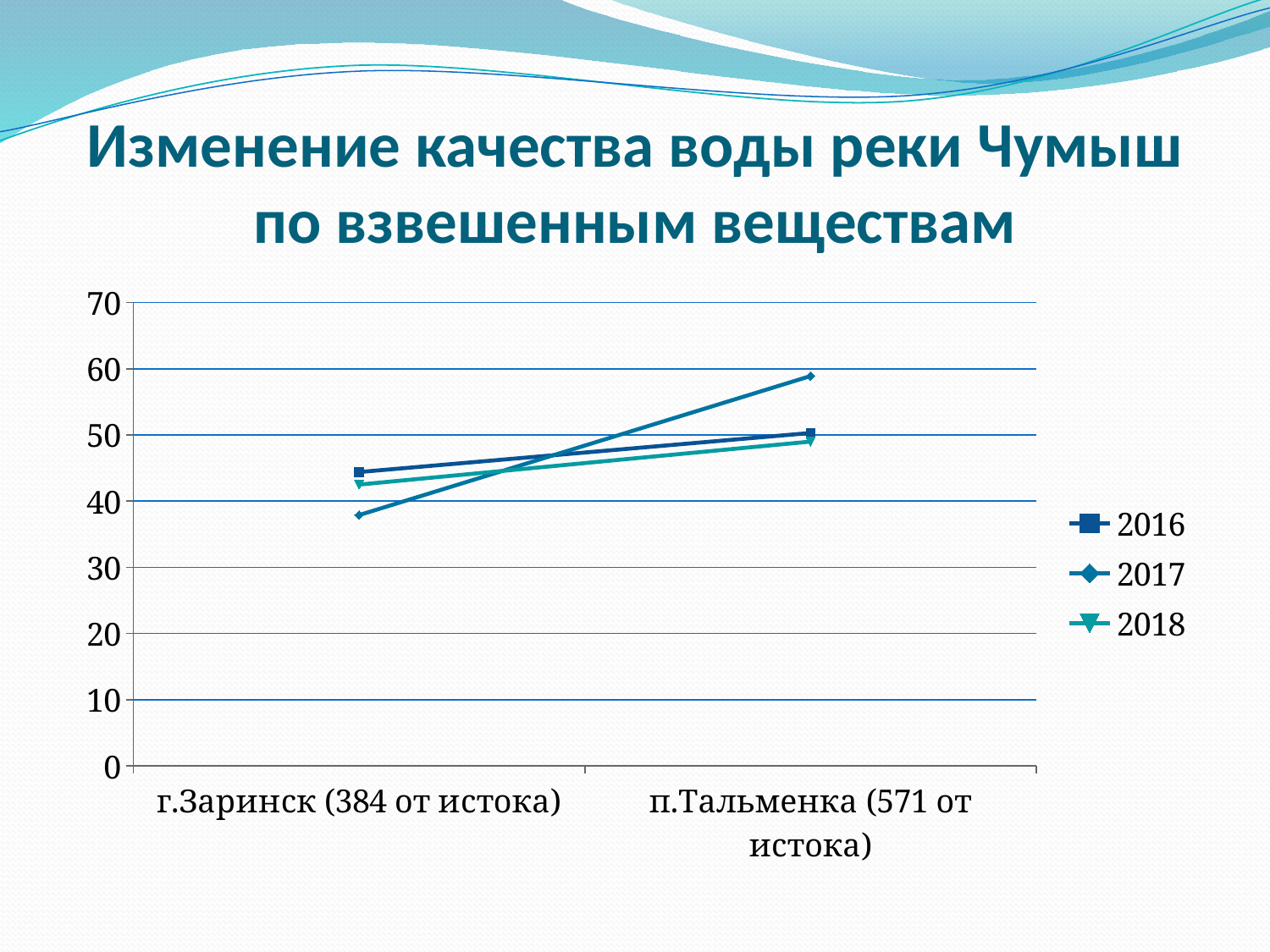
Does the 2017 series rise or fall from г.Заринск to п.Тальменка? rise Is the value for 2016 at г.Заринск (384 от истока) greater or less than 40? greater How many categories are shown on the x axis? 2 How many series does the legend list? 3 What is the title of the chart on the slide? Изменение качества воды реки Чумыш по взвешенным веществам Is the value for 2017 at г.Заринск (384 от истока) greater or less than 40? less At п.Тальменка (571 от истока), which is larger: the value for 2017 or the value for 2016? 2017 Which series has the highest value at п.Тальменка (571 от истока)? 2017 Is the value for 2017 at п.Тальменка (571 от истока) greater or less than 50? greater At г.Заринск (384 от истока), which is larger: the value for 2016 or the value for 2017? 2016 Which series has the lowest value at г.Заринск (384 от истока)? 2017 What kind of chart is shown on the slide? line chart